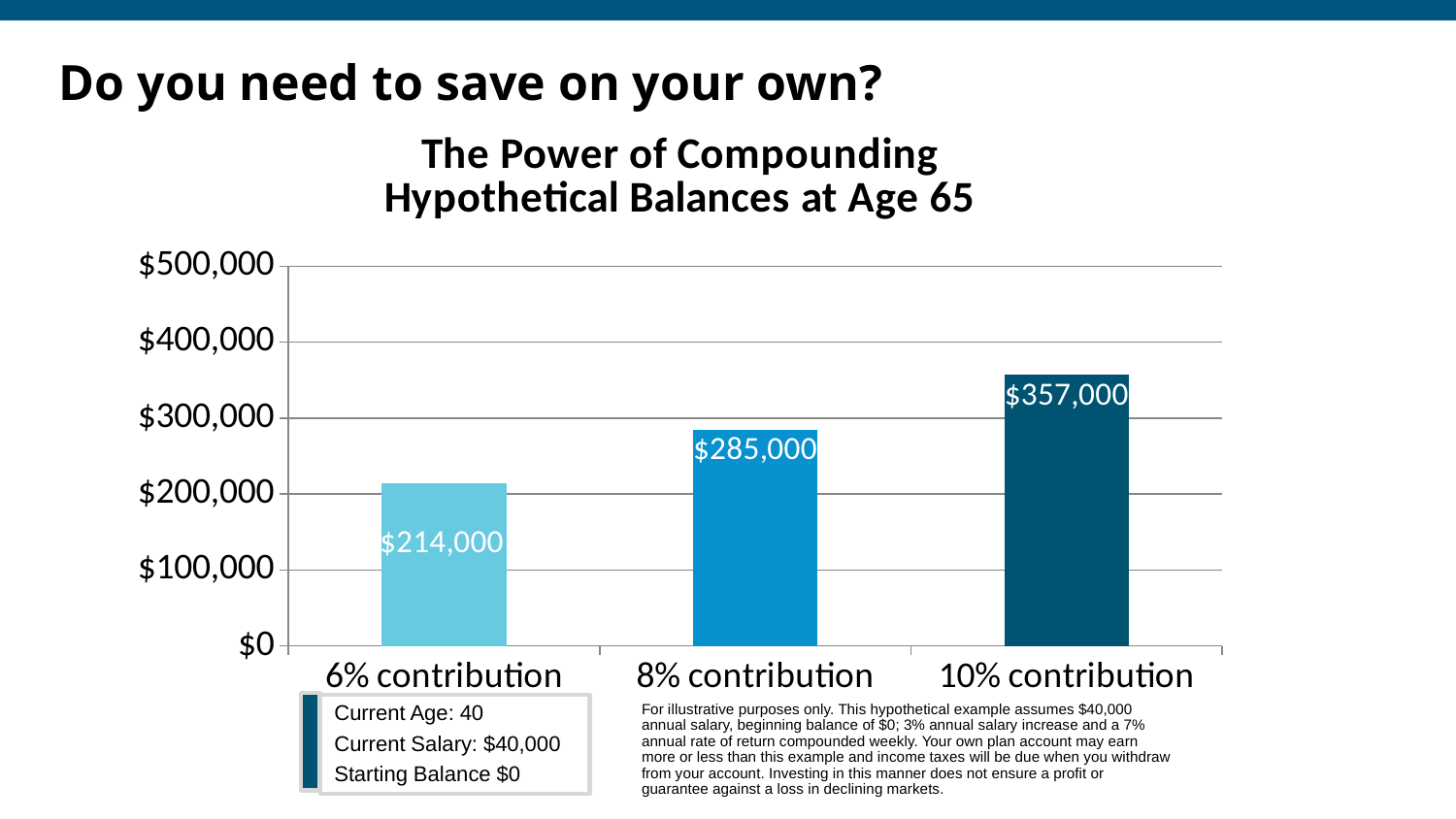
What is the hypothetical balance at age 65 for the 8% contribution? $285,000 Is the balance for the 10% contribution greater or less than $300,000? greater Which is larger, the balance for the 8% contribution or the 6% contribution? 8% contribution Do the balances rise or fall as the contribution percentage increases from 6% to 10%? Rise Which contribution level has the highest balance at age 65? 10% contribution What is the difference between the balances for the 10% contribution and the 6% contribution? $143,000 What is the hypothetical balance at age 65 for the 6% contribution? $214,000 What kind of chart is shown on the slide? Bar chart How many contribution levels are shown in the chart? 3 What is the hypothetical balance at age 65 for the 10% contribution? $357,000 What is the difference between the balances for the 8% contribution and the 6% contribution? $71,000 Which contribution level has the lowest balance at age 65? 6% contribution